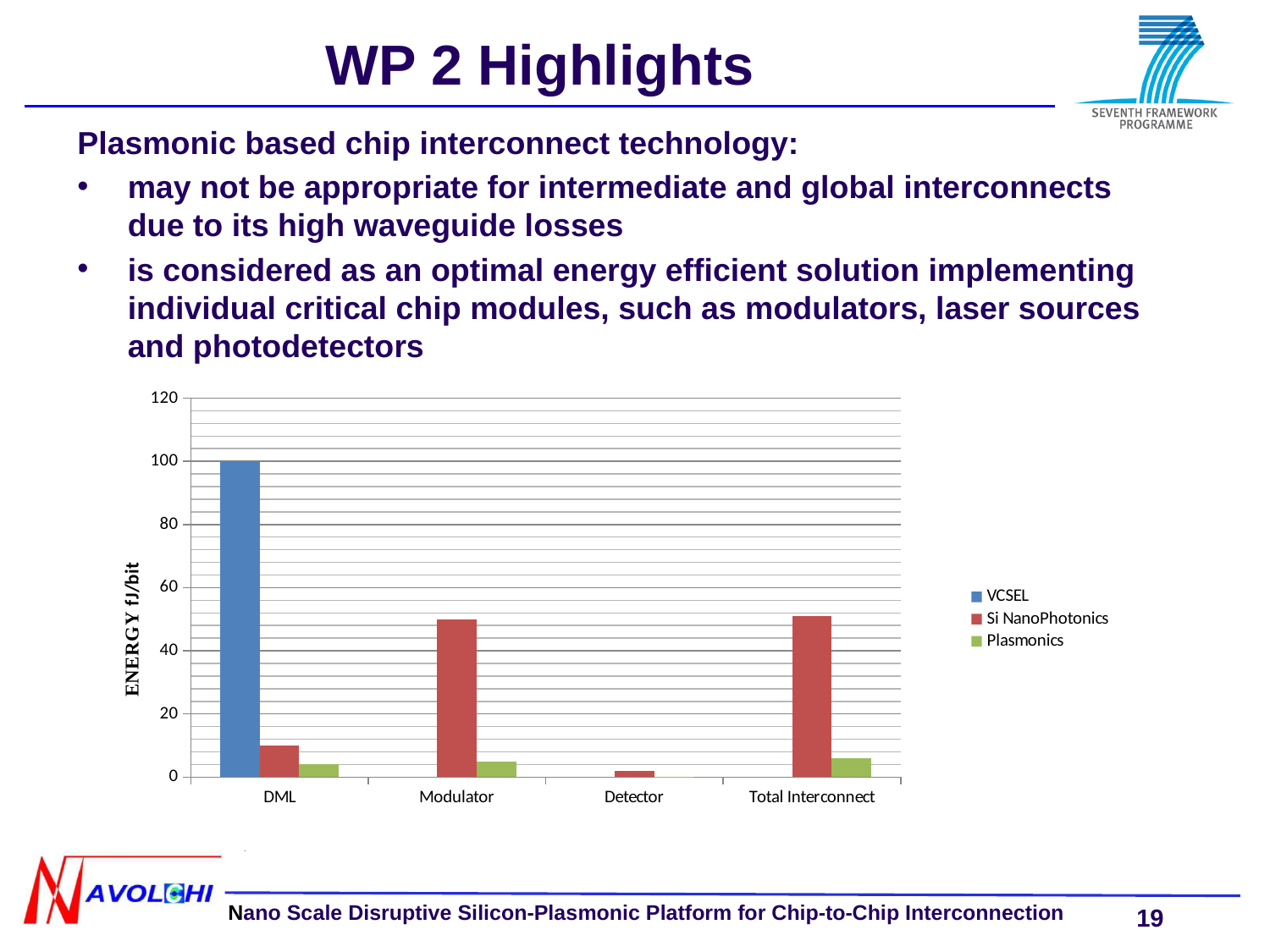
For which category is the Si NanoPhotonics value lowest? Detector Is the Si NanoPhotonics value for Modulator greater or less than 40? greater Which series has the tallest bar in the whole chart, and for which category? VCSEL, DML Is the Si NanoPhotonics value for DML greater or less than 20? less What is the label on the y axis of the chart? ENERGY fJ/bit What kind of chart is shown on the slide? bar chart What is the VCSEL value for DML? 100 For Modulator, which is larger: Si NanoPhotonics or Plasmonics? Si NanoPhotonics Is the Si NanoPhotonics value for Modulator greater or less than 60? less How many categories are shown on the x axis of the chart? 4 How many series does the chart legend list? 3